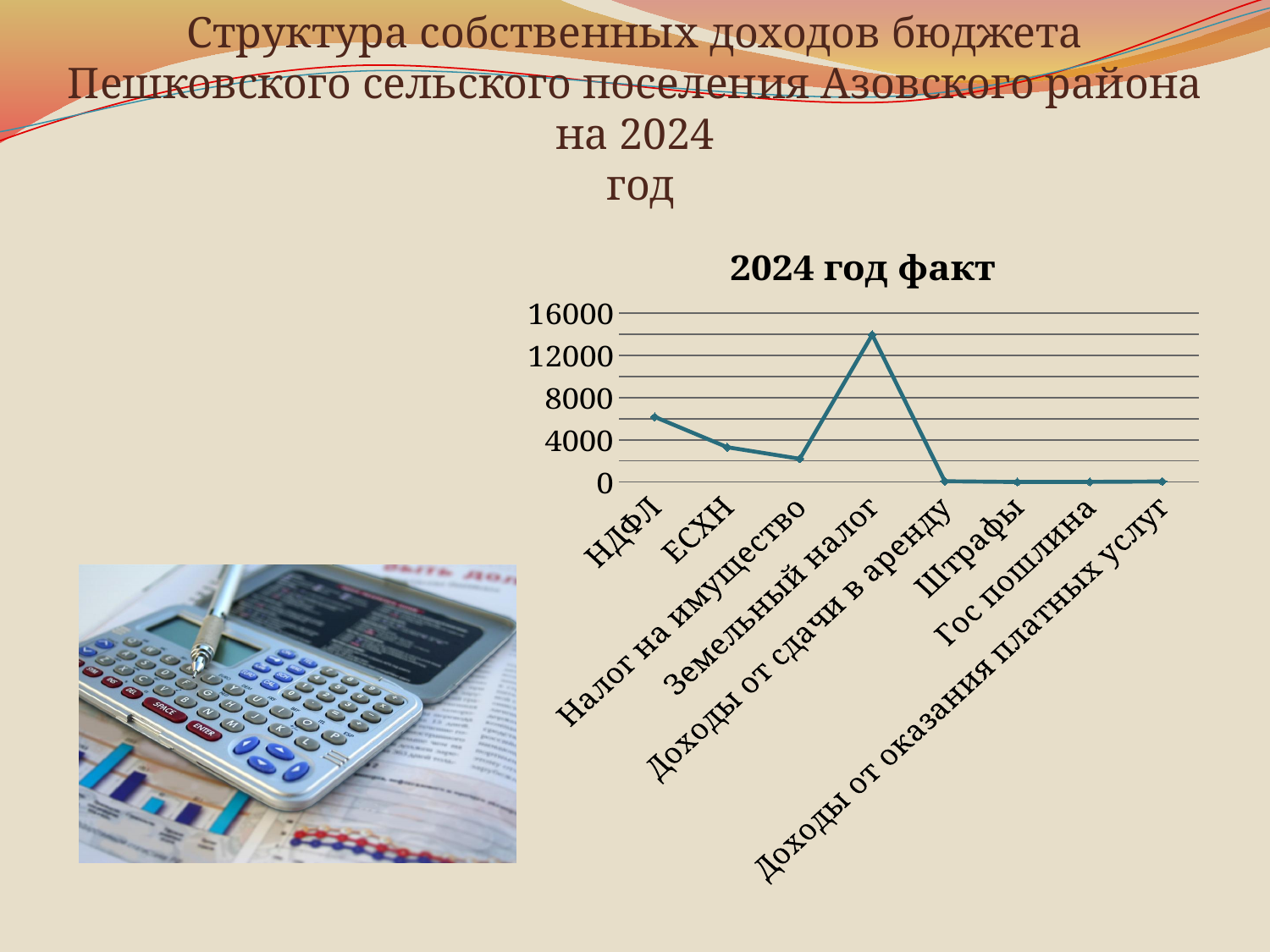
How many categories are plotted along the x axis of the chart? 8 What is the title of the chart? 2024 год факт Which category has the highest value in the chart? Земельный налог Is the value for Штрафы greater or less than 4000? less Does the line rise or fall from Земельный налог to Доходы от сдачи в аренду? fall What kind of chart is shown on the slide? line chart Is the value for Земельный налог greater or less than 12000? greater Is the value for Налог на имущество greater or less than 4000? less Which is larger, the value for НДФЛ or the value for ЕСХН? НДФЛ Which is larger, the value for Земельный налог or the value for НДФЛ? Земельный налог